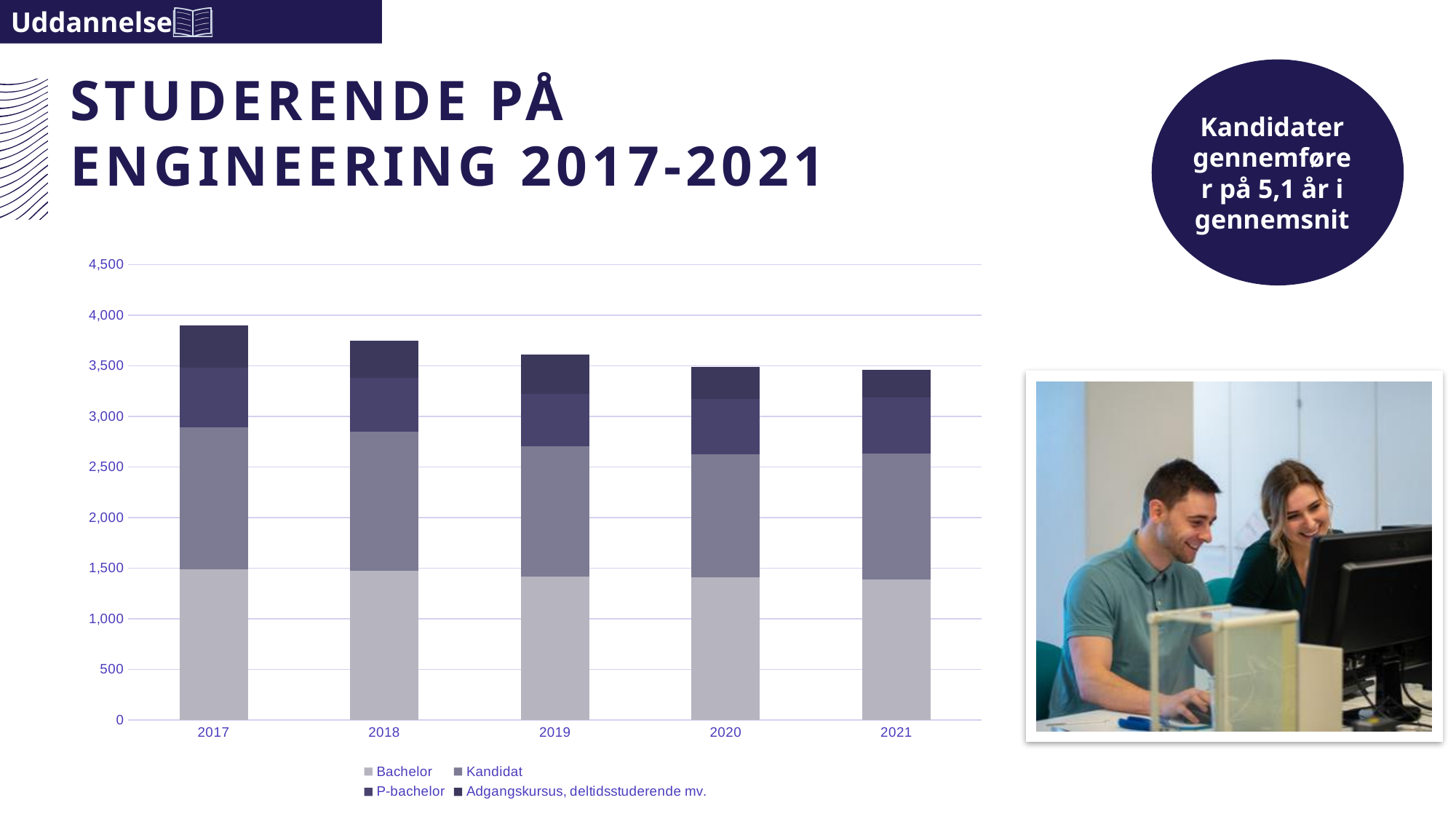
Is the Bachelor value for 2017 greater or less than 1,000? greater How many years are shown on the x axis of the chart? 5 Which year has the highest total bar in the chart? 2017 Which total bar is larger, 2017 or 2019? 2017 Is the total bar for 2017 greater or less than 3,500? greater What kind of chart is shown on the slide? Stacked bar chart Is the Bachelor value for 2021 greater or less than 1,500? less What is the title of the slide containing the chart? Studerende på Engineering 2017-2021 How many series does the chart legend list? 4 Do the total bar heights rise or fall from 2017 to 2021? Fall Which series is shown at the bottom of each stacked bar? Bachelor